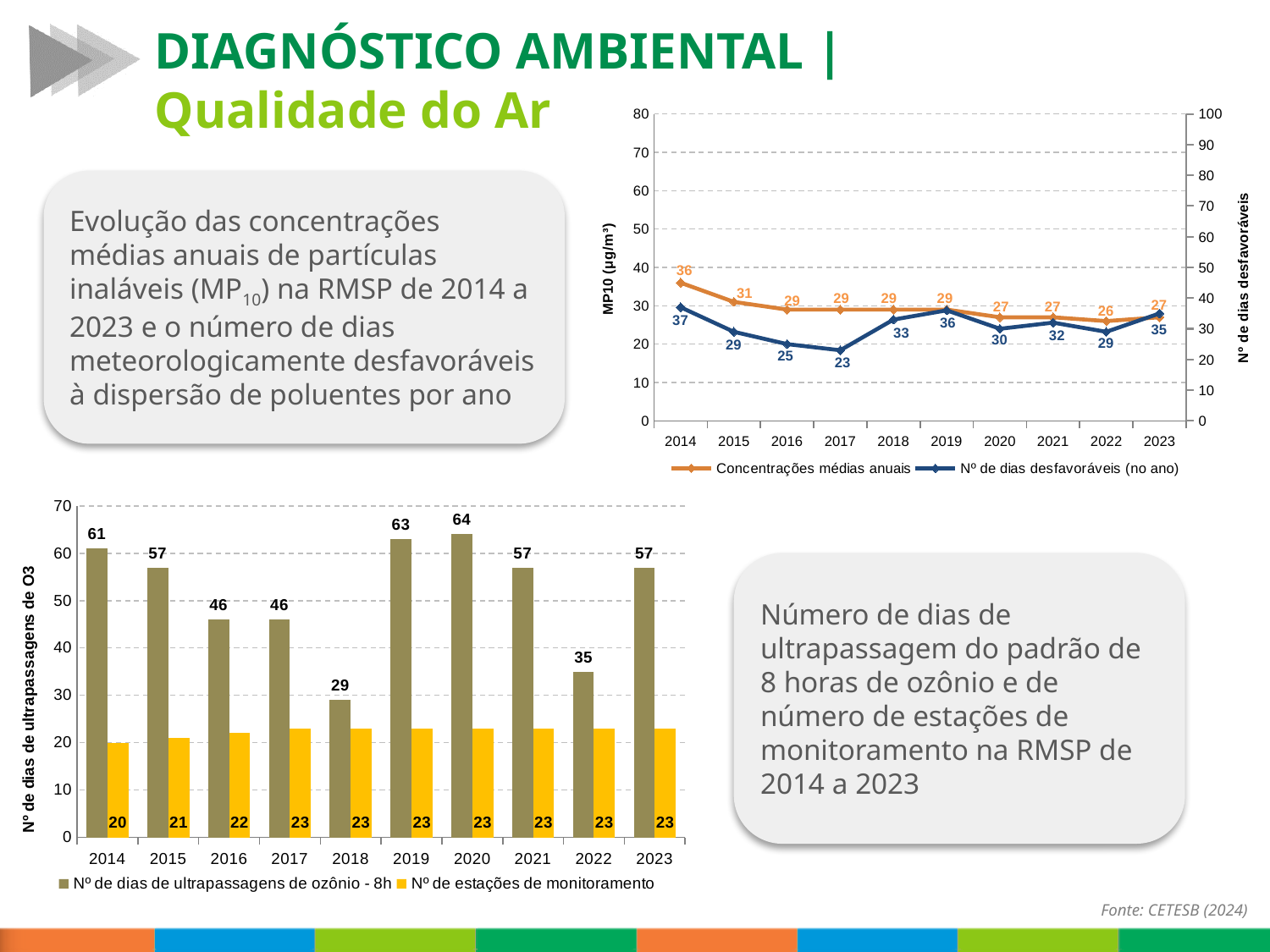
In the bar chart at the bottom left, what is the value of 'Nº de dias de ultrapassagens de ozônio - 8h' for 2020? 64 In the bar chart at the bottom left, what is the difference between the 'Nº de dias de ultrapassagens de ozônio - 8h' values for 2019 and 2022? 28 What type of chart is shown at the bottom left of the slide? bar chart In the line chart at the top right, which year has the highest value for 'Concentrações médias anuais'? 2014 In the line chart at the top right, does 'Concentrações médias anuais' generally rise or fall from 2014 to 2023? fall In the line chart at the top right, how many series does the legend list? 2 In the line chart at the top right, what is the value of 'Nº de dias desfavoráveis (no ano)' for 2017? 23 In the bar chart at the bottom left, which year has the lowest value for 'Nº de dias de ultrapassagens de ozônio - 8h'? 2018 In the line chart at the top right, what is the value of 'Concentrações médias anuais' for 2014? 36 In the line chart at the top right, which year has the lowest value for 'Nº de dias desfavoráveis (no ano)'? 2017 In the line chart at the top right, what is the difference between the 'Nº de dias desfavoráveis (no ano)' values for 2014 and 2017? 14 In the bar chart at the bottom left, how many years are shown on the x axis? 10